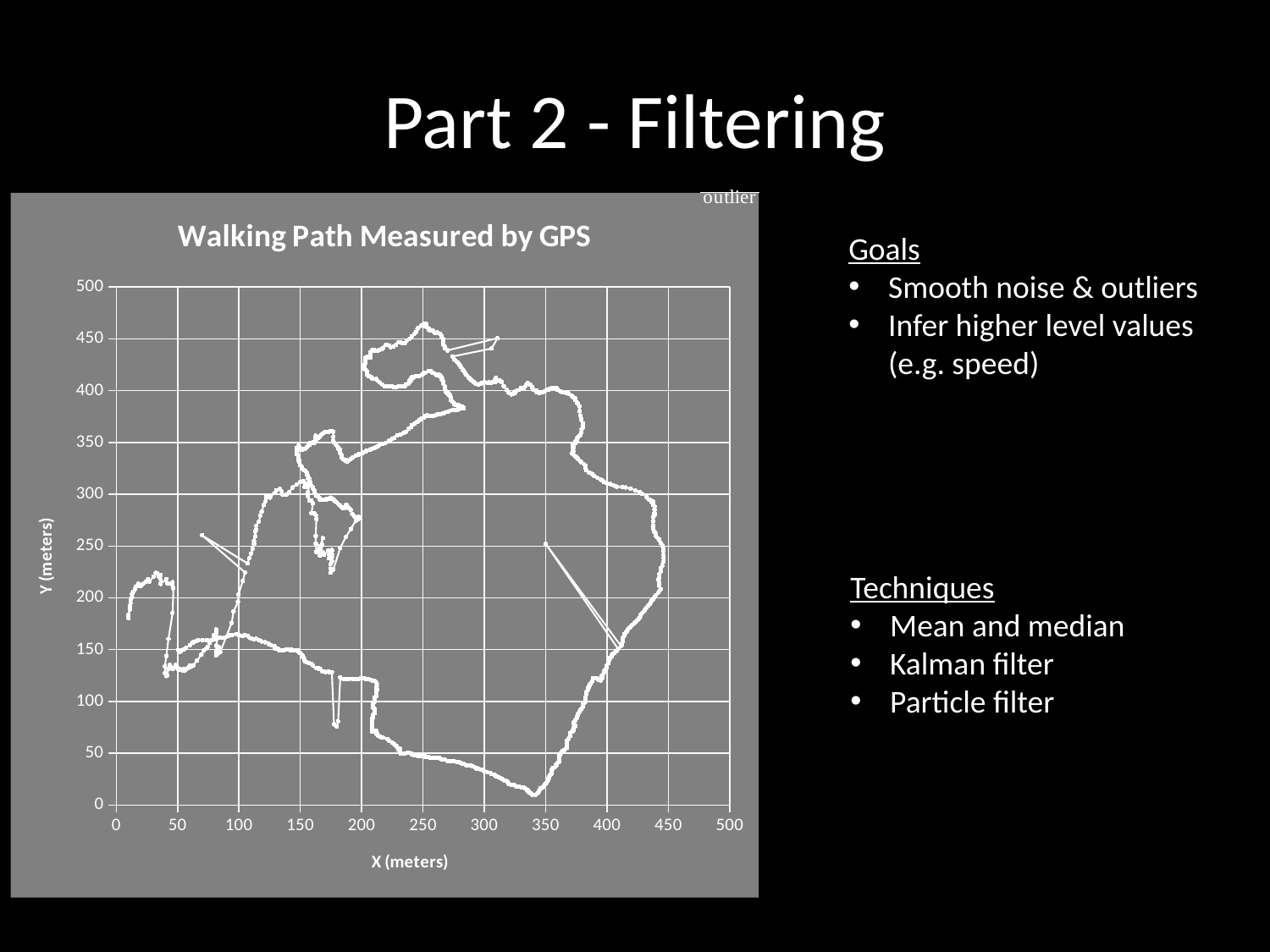
What is the label of the x axis? X (meters) Is the largest X value reached by the walking path greater or less than 400? greater What is the title of the chart? Walking Path Measured by GPS Is the lowest Y value reached by the walking path greater or less than 50? less Is the largest X value reached by the walking path greater or less than 500? less What kind of chart is shown on the slide? scatter chart